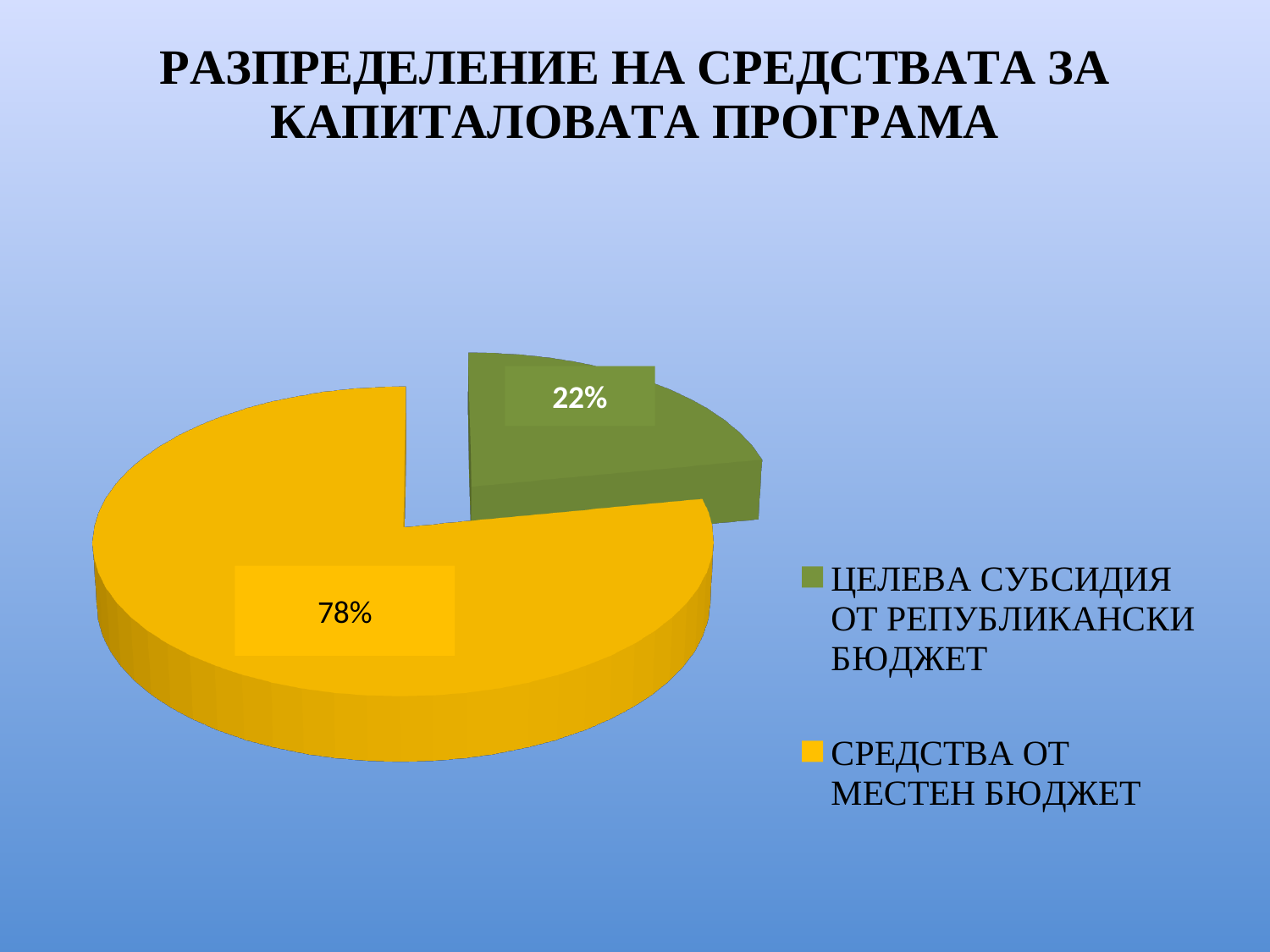
What kind of chart is shown on the slide? Pie chart Which category has the smallest slice of the pie? ЦЕЛЕВА СУБСИДИЯ ОТ РЕПУБЛИКАНСКИ БЮДЖЕТ What share of the pie does СРЕДСТВА ОТ МЕСТЕН БЮДЖЕТ represent? 78% How many slices does the pie chart have? 2 Which is larger: the share for ЦЕЛЕВА СУБСИДИЯ ОТ РЕПУБЛИКАНСКИ БЮДЖЕТ or the share for СРЕДСТВА ОТ МЕСТЕН БЮДЖЕТ? СРЕДСТВА ОТ МЕСТЕН БЮДЖЕТ What share of the pie does ЦЕЛЕВА СУБСИДИЯ ОТ РЕПУБЛИКАНСКИ БЮДЖЕТ represent? 22% What colour is the slice for ЦЕЛЕВА СУБСИДИЯ ОТ РЕПУБЛИКАНСКИ БЮДЖЕТ? Green What is the title of the slide? РАЗПРЕДЕЛЕНИЕ НА СРЕДСТВАТА ЗА КАПИТАЛОВАТА ПРОГРАМА What is the difference in percentage points between the share for СРЕДСТВА ОТ МЕСТЕН БЮДЖЕТ and the share for ЦЕЛЕВА СУБСИДИЯ ОТ РЕПУБЛИКАНСКИ БЮДЖЕТ? 56% How many entries does the legend list? 2 Which category has the largest slice of the pie? СРЕДСТВА ОТ МЕСТЕН БЮДЖЕТ What is the total of the two percentages shown on the pie chart? 100%